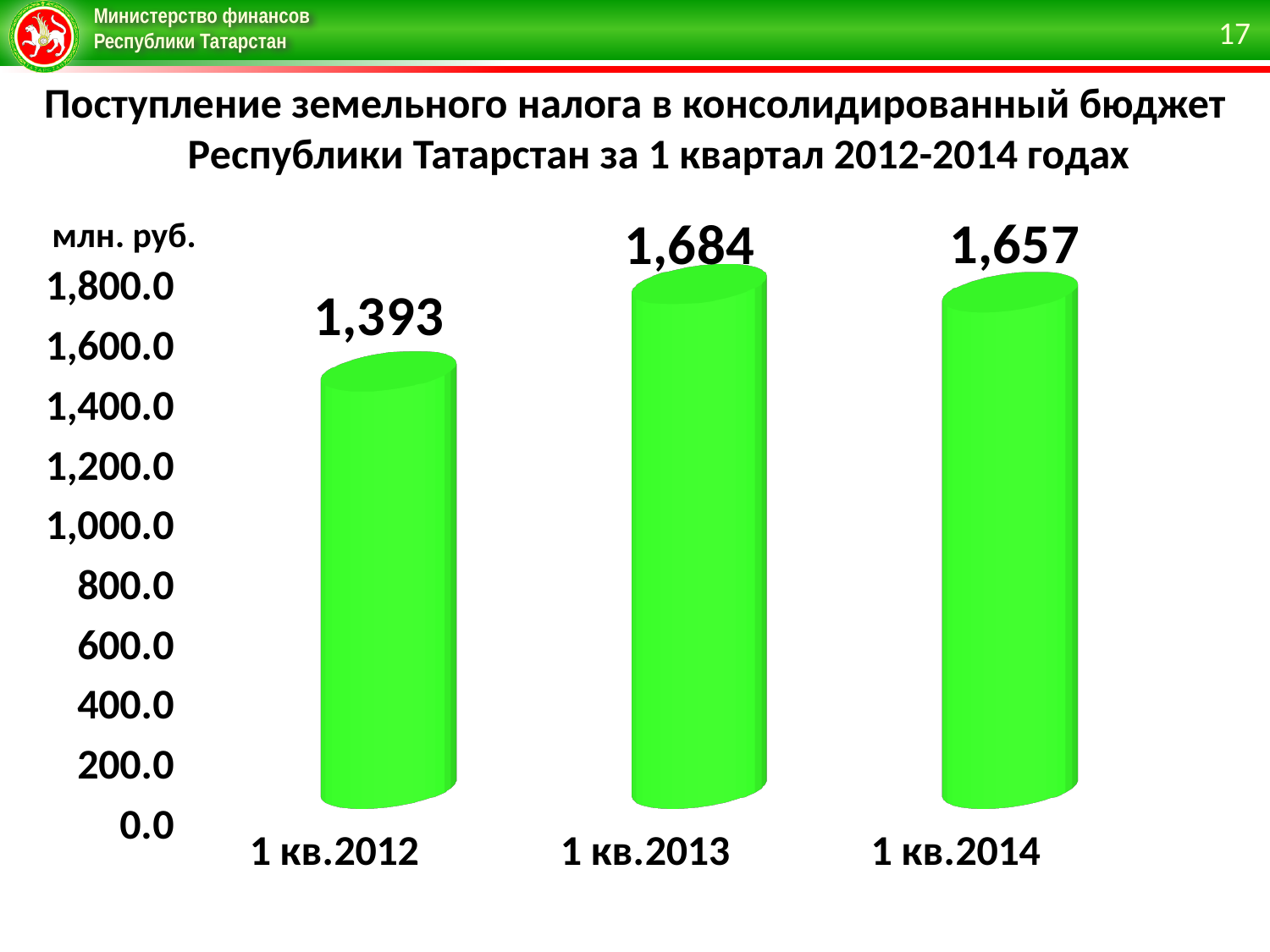
What is the value for 1 кв.2014? 1,657 Is the value for 1 кв.2012 greater or less than 1,600.0? less Which category has the lowest value? 1 кв.2012 How many categories are shown on the chart? 3 Which is larger, the value for 1 кв.2012 or the value for 1 кв.2014? 1 кв.2014 What kind of chart is shown on the slide? bar chart What unit is shown for the values on the chart? млн. руб. What is the value for 1 кв.2012? 1,393 Which category has the highest value? 1 кв.2013 What is the difference between the values for 1 кв.2013 and 1 кв.2014? 27 What is the value for 1 кв.2013? 1,684 What is the difference between the values for 1 кв.2013 and 1 кв.2012? 291